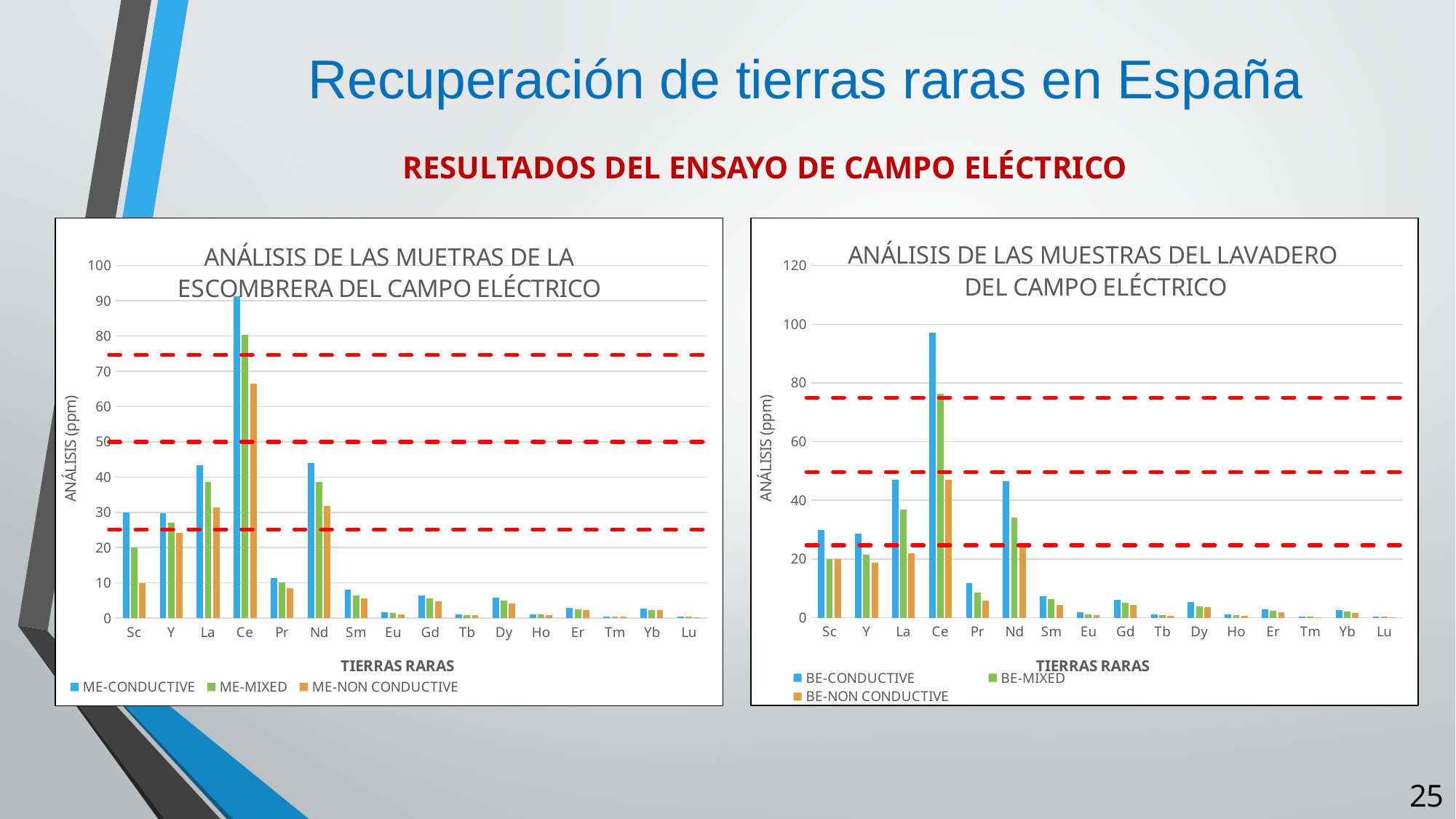
What type of chart is the left chart, 'ANÁLISIS DE LAS MUETRAS DE LA ESCOMBRERA DEL CAMPO ELÉCTRICO'? Bar chart In the left chart (escombrera), is the ME-CONDUCTIVE value for Ce greater or less than 80? greater In the right chart (lavadero), which category has the highest BE-CONDUCTIVE value? Ce In the left chart (escombrera), which is larger for Sc: the ME-CONDUCTIVE value or the ME-NON CONDUCTIVE value? ME-CONDUCTIVE In the right chart (lavadero), is the BE-CONDUCTIVE value for Pr greater or less than 20? less In the right chart (lavadero), is the BE-MIXED value for Ce greater or less than 60? greater How many categories are shown on the x axis of the right chart (lavadero)? 16 How many series does the legend of the left chart (escombrera) list? 3 What is the y-axis label of the right chart (lavadero)? ANÁLISIS (ppm) In the right chart (lavadero), which is larger for Nd: the BE-CONDUCTIVE value or the BE-MIXED value? BE-CONDUCTIVE In the left chart (escombrera), which category has the highest ME-CONDUCTIVE value? Ce